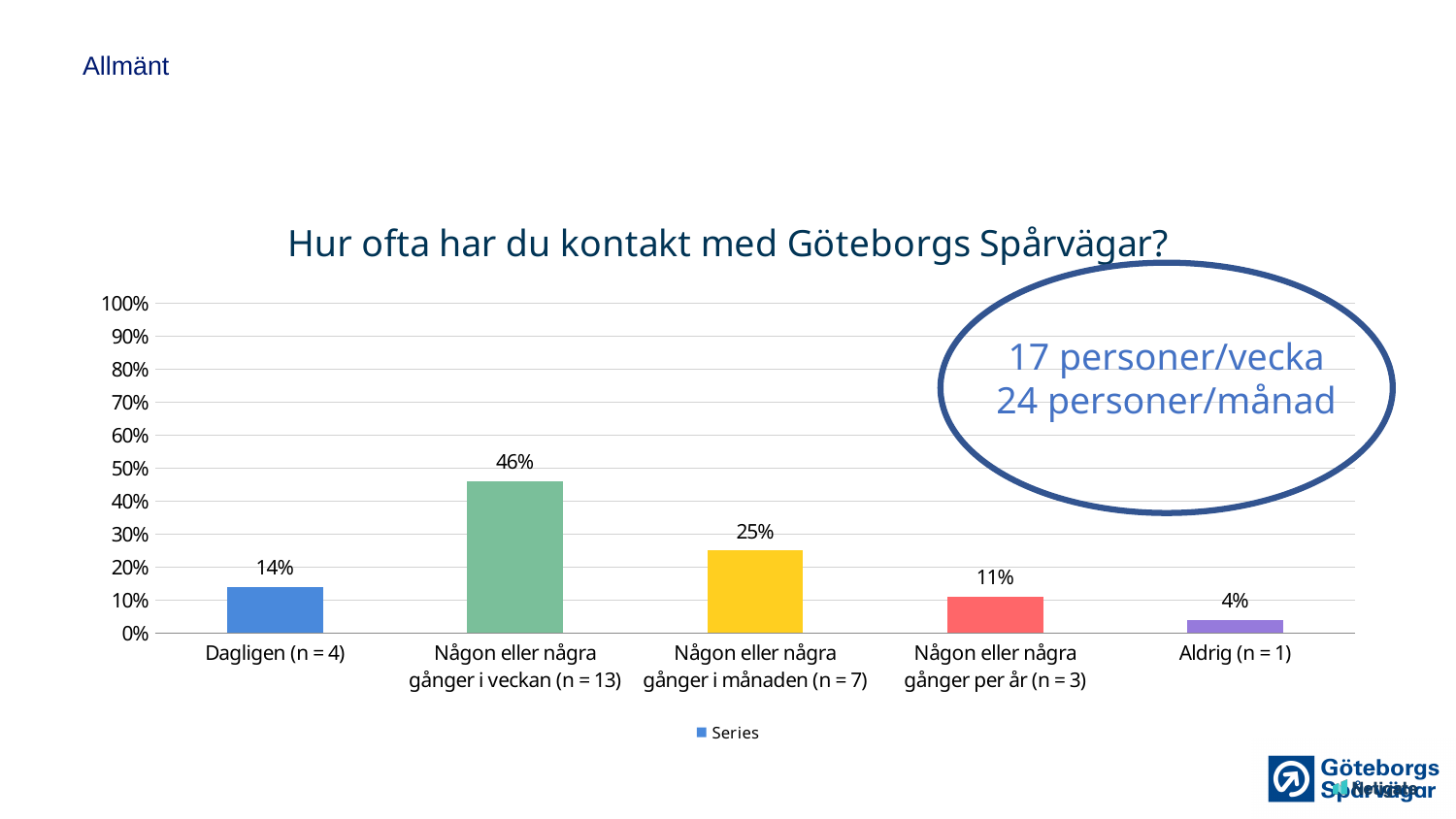
Which category has the highest value? Någon eller några gånger i veckan (n = 13) Is the value for "Någon eller några gånger i veckan (n = 13)" greater or less than 40%? greater Which is larger, the value for "Dagligen (n = 4)" or the value for "Någon eller några gånger per år (n = 3)"? Dagligen (n = 4) What is the value for "Dagligen (n = 4)"? 14% What is the title of the chart? Hur ofta har du kontakt med Göteborgs Spårvägar? What is the difference between the values for "Någon eller några gånger i veckan (n = 13)" and "Någon eller några gånger i månaden (n = 7)"? 21% Which category has the lowest value? Aldrig (n = 1) What is the value for "Aldrig (n = 1)"? 4% How many categories are shown on the x axis? 5 What kind of chart is shown on the slide? Bar chart What is the value for "Någon eller några gånger i månaden (n = 7)"? 25% What is the value for "Någon eller några gånger i veckan (n = 13)"? 46%